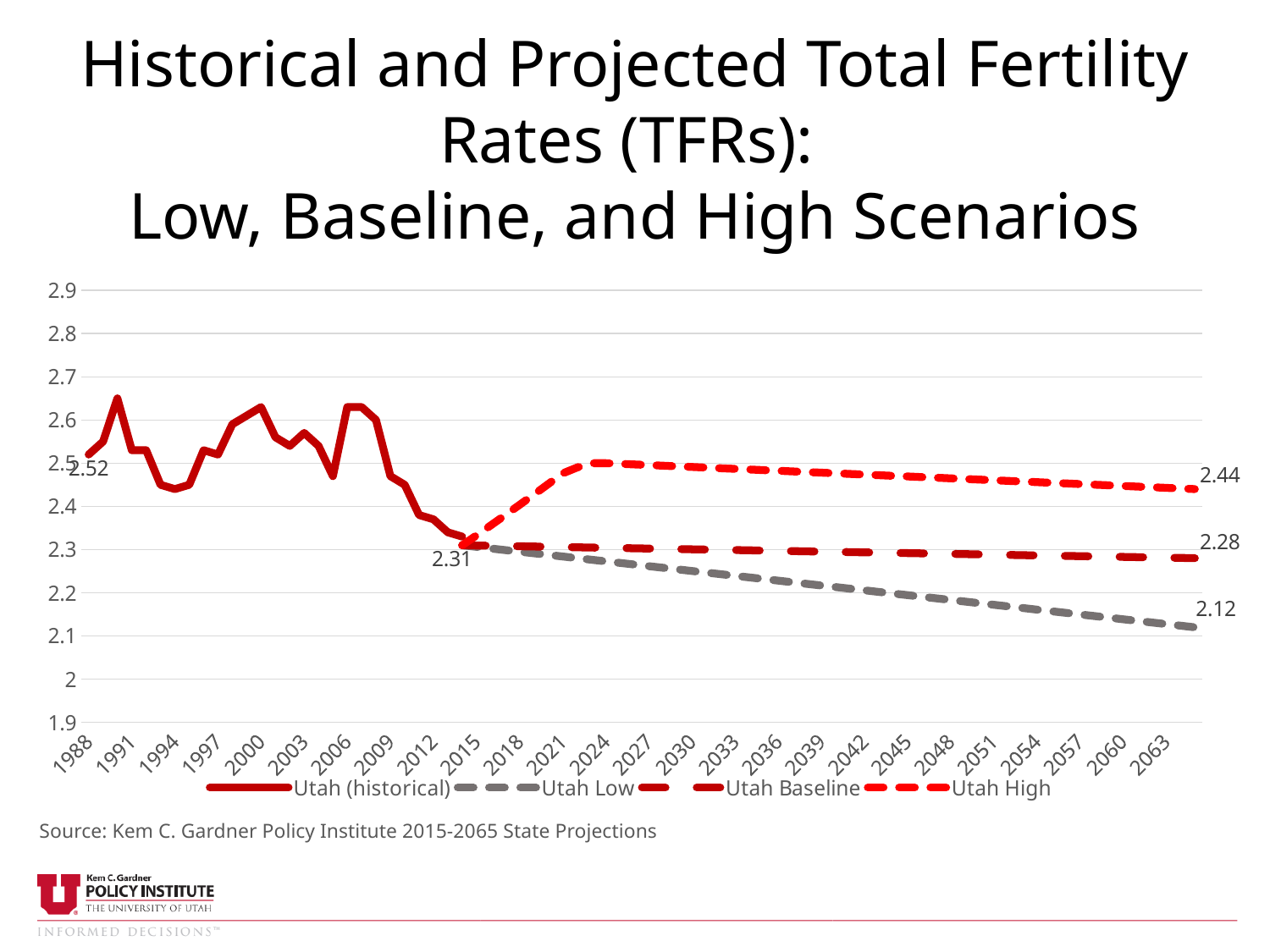
What kind of chart is shown on the slide? line chart What is the labelled value of the Utah (historical) series at the start of the chart in 1988? 2.52 What is the labelled value of the Utah Low series at the end of the projection? 2.12 Does the Utah Low series rise or fall from 2015 to the end of the chart? fall Is the value of the Utah Low series in 2045 greater or less than 2.3? less What is the difference between the final labelled values of the Utah Baseline and Utah Low series? 0.16 What is the difference between the final labelled values of the Utah High and Utah Low series? 0.32 Which series ends at the highest value at the right end of the chart? Utah High What is the labelled value of the Utah Baseline series at the end of the projection? 2.28 What is the labelled value where the historical series ends and the projections begin, around 2015? 2.31 How many series does the legend list? 4 What is the labelled value of the Utah High series at the end of the projection? 2.44